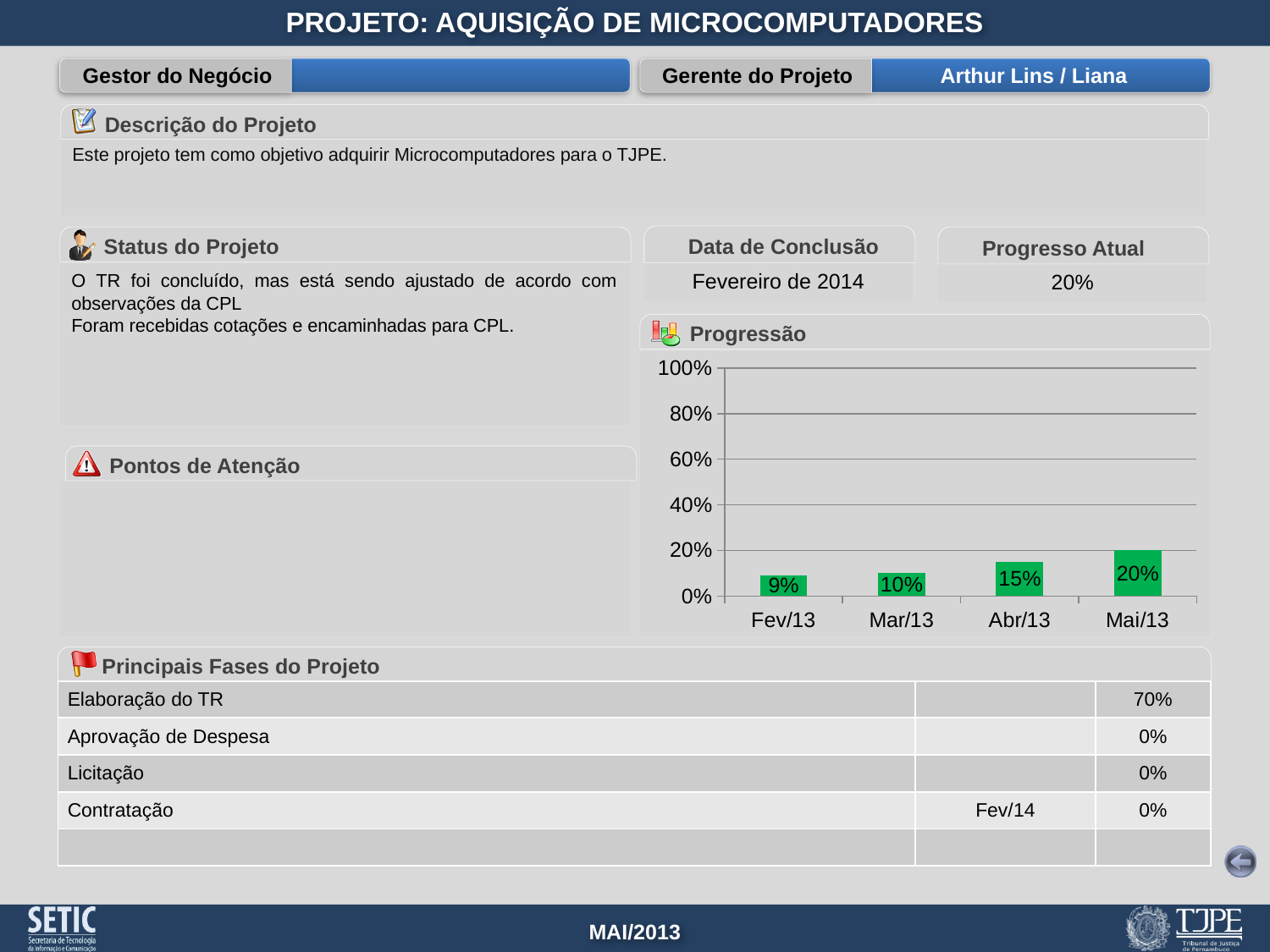
Which month has the lowest value in the Progressão chart? Fev/13 What kind of chart is the Progressão chart? bar chart Is the value for Mai/13 in the Progressão chart greater or less than 40%? less Which month has the highest value in the Progressão chart? Mai/13 What is the difference between the values for Abr/13 and Mar/13 in the Progressão chart? 5% What is the value for Abr/13 in the Progressão chart? 15% What is the value for Fev/13 in the Progressão chart? 9% What is the difference between the values for Mai/13 and Fev/13 in the Progressão chart? 11% What is the value for Mar/13 in the Progressão chart? 10% How many months are shown on the x axis of the Progressão chart? 4 What is the value for Mai/13 in the Progressão chart? 20% Which is larger in the Progressão chart, the value for Abr/13 or the value for Mar/13? Abr/13